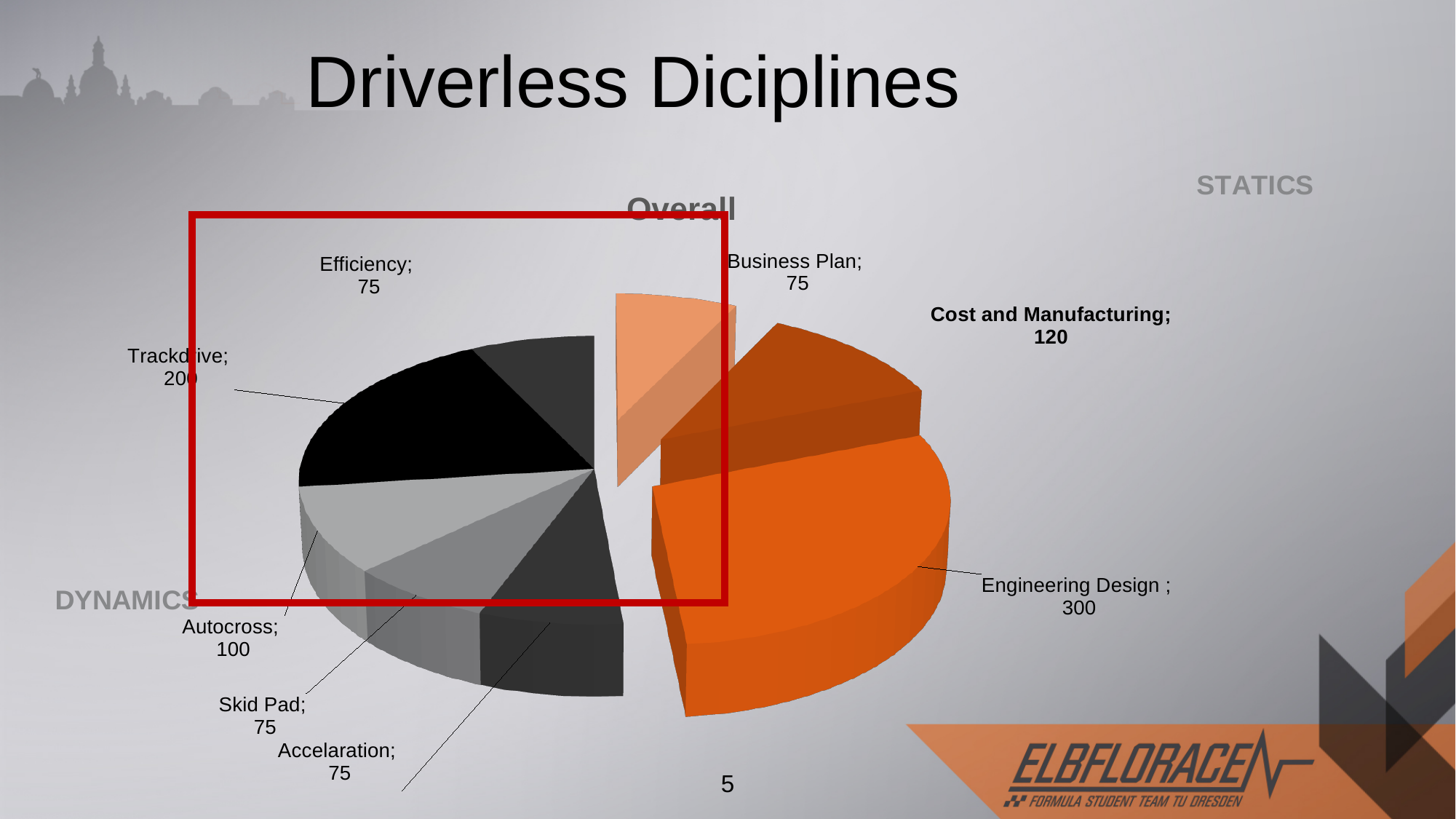
What share of the pie does Engineering Design represent, to the nearest whole percent? 29% What is the value for Cost and Manufacturing? 120 What is the total of all the slice values in the pie chart? 1020 What is the value for Autocross? 100 What kind of chart is shown on the slide? Pie chart How many slices does the pie chart have? 8 What is the value for Engineering Design? 300 What is the difference between the values for Engineering Design and Trackdrive? 100 Which is larger, the value for Cost and Manufacturing or the value for Autocross? Cost and Manufacturing What is the value for Trackdrive? 200 Which category has the largest slice? Engineering Design What is the title of the chart? Overall